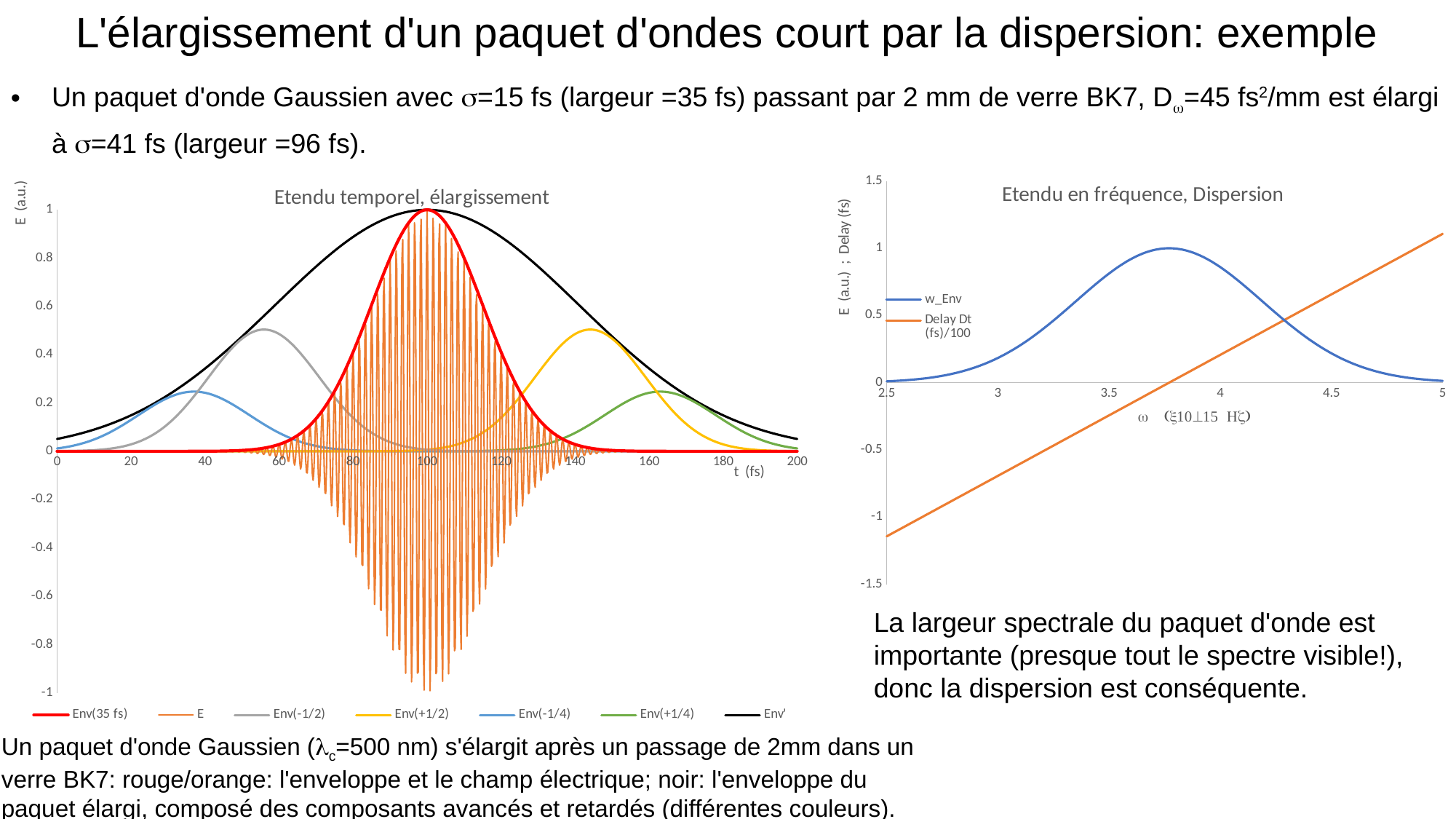
What kind of chart is the right chart titled 'Etendu en fréquence, Dispersion'? line chart In the left chart 'Etendu temporel, élargissement', which series has the higher peak, Env(-1/2) or Env(+1/4)? Env(-1/2) In the left chart 'Etendu temporel, élargissement', is the peak value of the Env(-1/4) series greater or less than 0.4? less In the right chart 'Etendu en fréquence, Dispersion', what colour is the 'w_Env' series? blue In the left chart 'Etendu temporel, élargissement', is the peak value of the Env(-1/2) series greater or less than 0.4? greater How many series does the legend of the right chart 'Etendu en fréquence, Dispersion' list? 2 In the right chart 'Etendu en fréquence, Dispersion', is the value of 'Delay Dt (fs)/100' at ω=2.5 greater or less than -1? less What kind of chart is the left chart titled 'Etendu temporel, élargissement'? line chart What is the x-axis label of the left chart 'Etendu temporel, élargissement'? t (fs) In the right chart 'Etendu en fréquence, Dispersion', does the 'Delay Dt (fs)/100' series rise or fall as ω increases? rise How many series does the legend of the left chart 'Etendu temporel, élargissement' list? 7